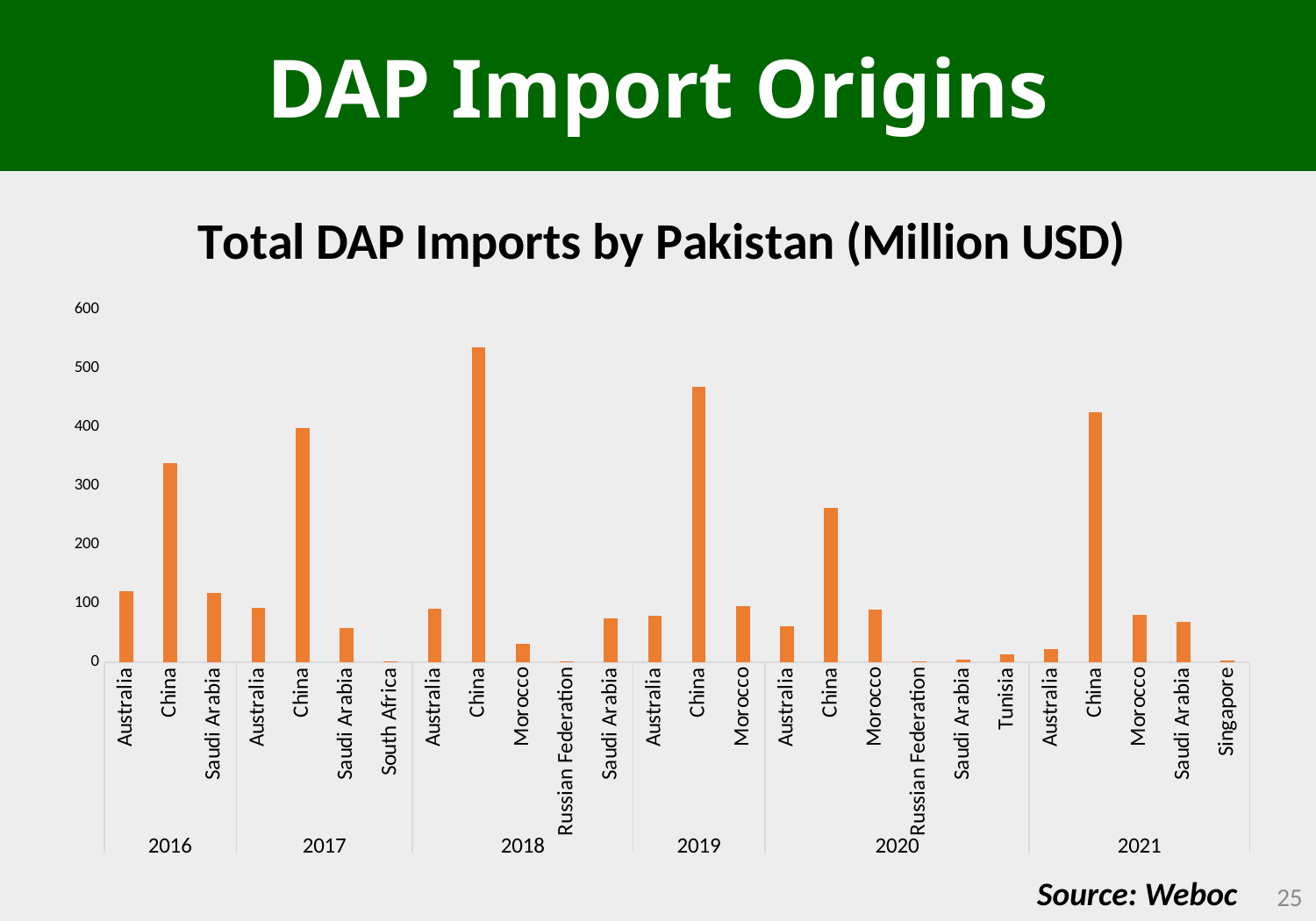
Is the value for China in 2020 greater or less than 300? less Which is larger: the value for China in 2019 or the value for China in 2021? China in 2019 Is the value for China in 2018 greater or less than 500? greater Which country and year has the highest bar in the chart? China, 2018 Is the value for Australia in 2016 greater or less than 100? greater What kind of chart is shown on the slide? Bar chart Which is larger: the value for Australia in 2016 or the value for Australia in 2021? Australia in 2016 How many years are shown along the x axis of the chart? 6 What is the title of the chart? Total DAP Imports by Pakistan (Million USD) How many countries are shown for the year 2020? 6